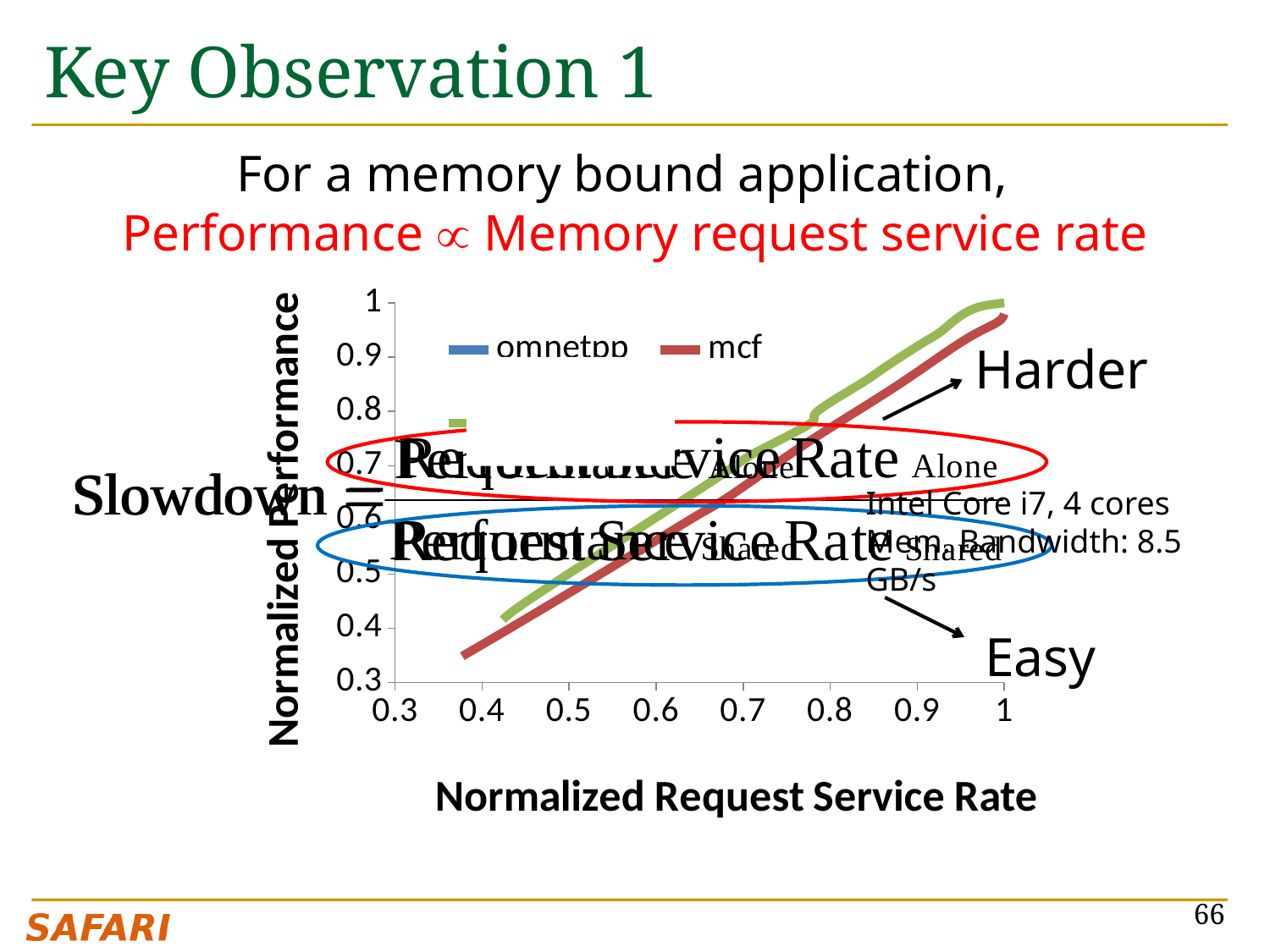
How many series does the chart legend list? 2 Is the Normalized Performance of mcf at a Normalized Request Service Rate of 0.7 greater or less than 0.6? greater What is the title of the x axis of the chart? Normalized Request Service Rate Is the Normalized Performance of mcf at a Normalized Request Service Rate of 0.9 greater or less than 0.8? greater What kind of chart is shown on the slide? line chart Is the Normalized Performance of mcf at a Normalized Request Service Rate of 1 greater or less than 0.9? greater Which series are listed in the chart legend? omnetpp and mcf Do the plotted lines rise or fall as Normalized Request Service Rate increases? rise